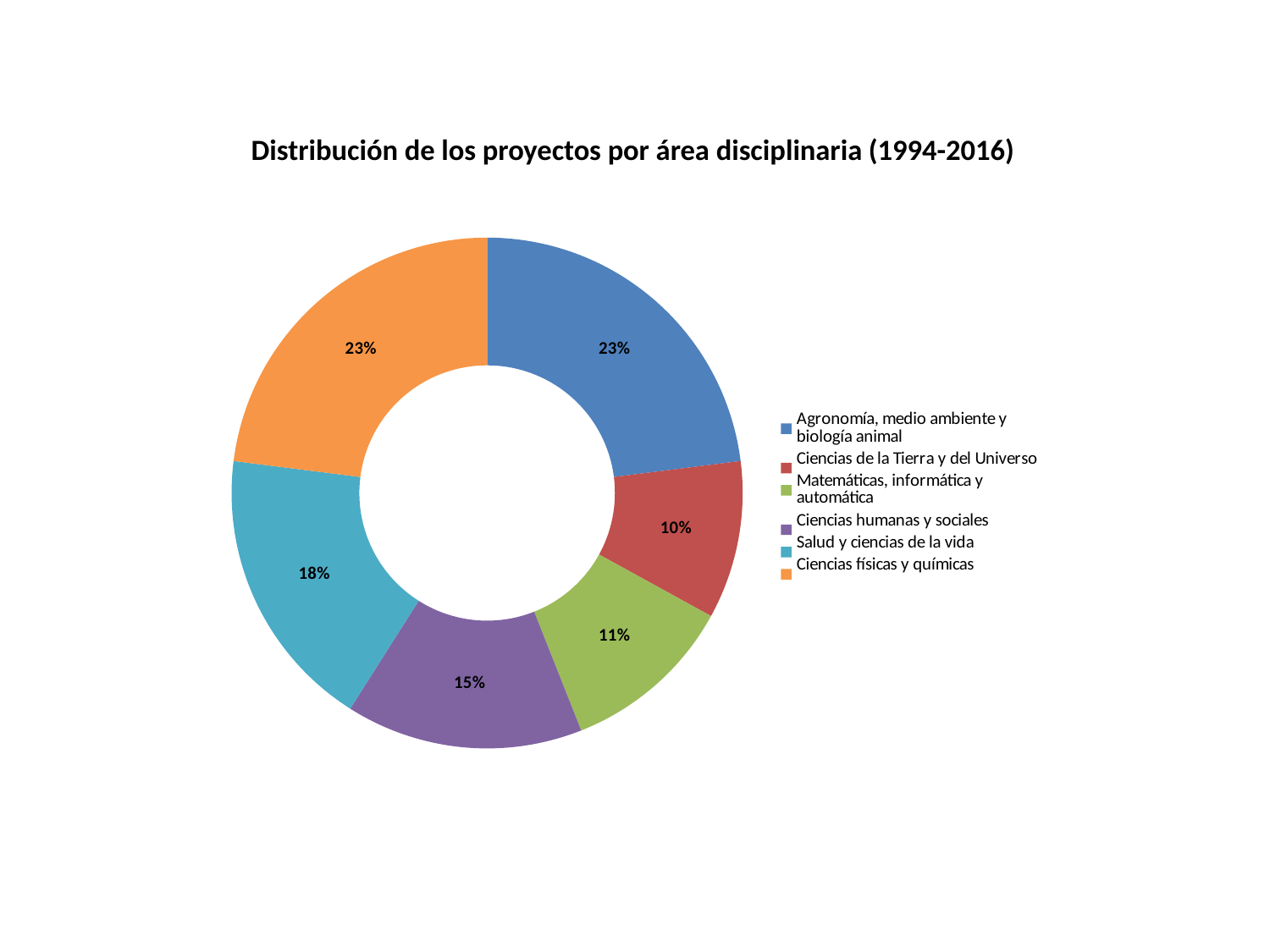
Which disciplinary area has the smallest share of projects? Ciencias de la Tierra y del Universo What is the title of the chart? Distribución de los proyectos por área disciplinaria (1994-2016) What percentage is shown for Salud y ciencias de la vida? 18% What is the difference in percentage points between Ciencias físicas y químicas and Salud y ciencias de la vida? 5 Which colour represents Ciencias físicas y químicas in the chart? orange What kind of chart is shown on the slide? doughnut chart What share of projects does Ciencias humanas y sociales account for? 15% What is the difference in percentage points between Ciencias humanas y sociales and Matemáticas, informática y automática? 4 Which has a larger share: Salud y ciencias de la vida or Ciencias humanas y sociales? Salud y ciencias de la vida How many disciplinary areas are shown in the chart? 6 What share of projects does Matemáticas, informática y automática represent? 11% What percentage is shown for Ciencias de la Tierra y del Universo? 10%